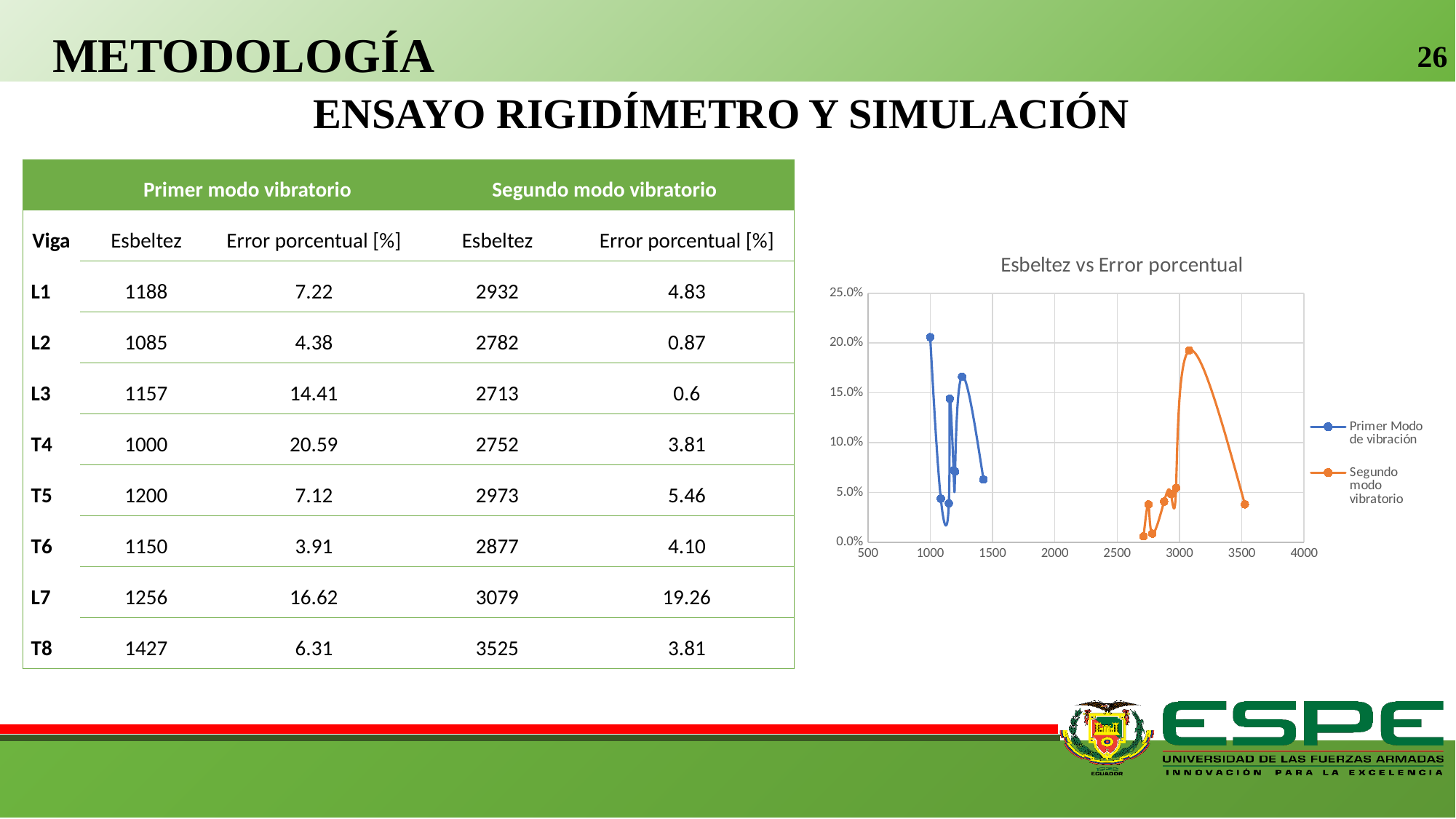
Which series in the chart has its points at the larger Esbeltez values on the x axis? Segundo modo vibratorio Is the Primer Modo de vibración point at an Esbeltez of about 1000 greater or less than 10.0%? greater Which series reaches the higher peak error value in the chart, Primer Modo de vibración or Segundo modo vibratorio? Primer Modo de vibración Which series in the chart is drawn in orange? Segundo modo vibratorio Is the Segundo modo vibratorio point at an Esbeltez of about 3500 greater or less than 5.0%? less What kind of chart is shown on the slide? line chart How many series does the chart legend list? 2 Does the Segundo modo vibratorio series rise or fall between an Esbeltez of about 3000 and 3500? fall What is the title of the chart on the slide? Esbeltez vs Error porcentual What is the maximum value shown on the chart's y axis? 25.0% Is the highest point of the Primer Modo de vibración series greater or less than 15.0%? greater